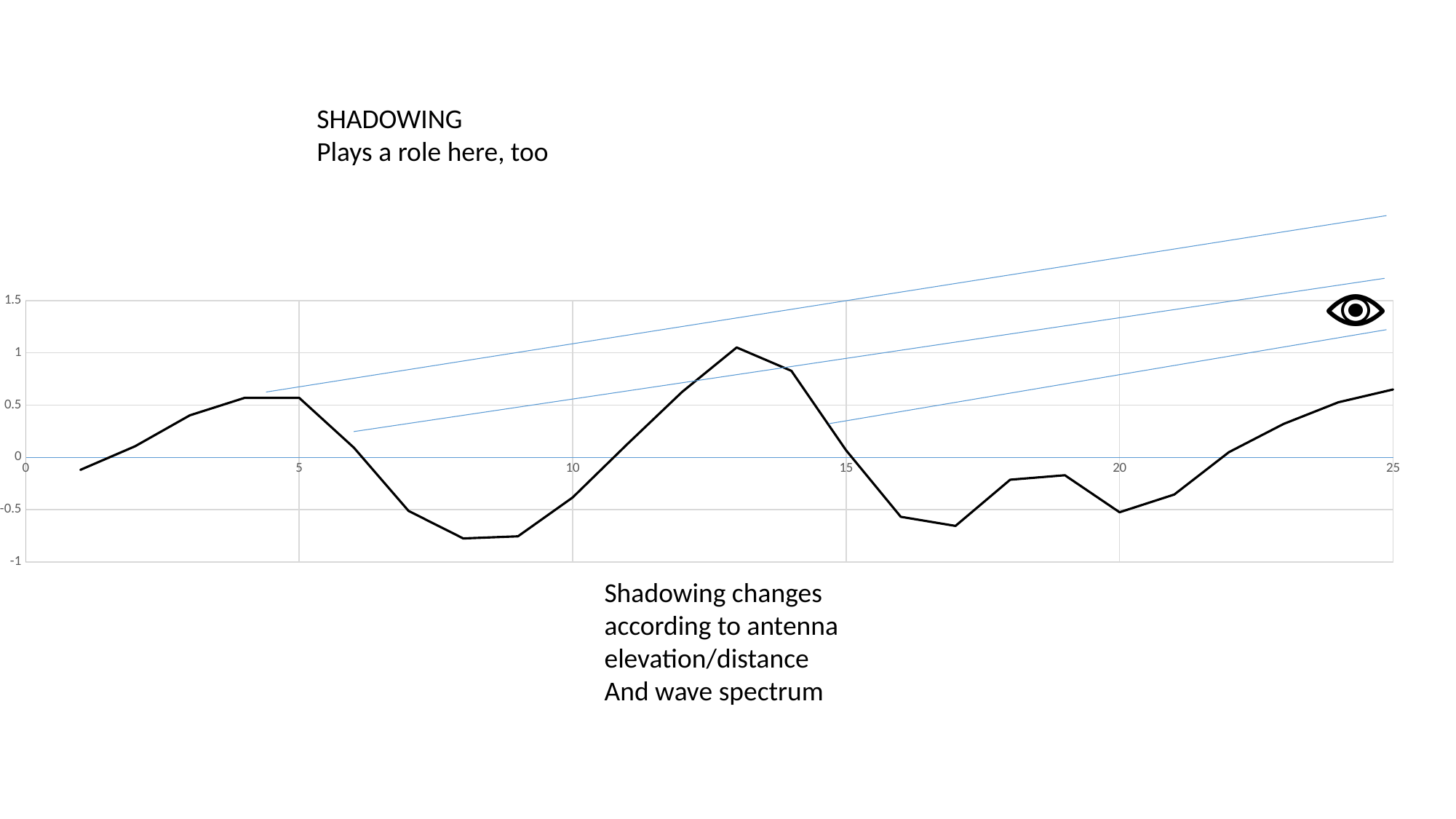
Is the value of the black line at x = 10 greater or less than 0? less Is the value of the black line at x = 12 greater or less than 0.5? greater Is the value of the black line at x = 25 greater or less than 0.5? greater What is the highest value labelled on the y axis? 1.5 What kind of chart is shown on the slide? line chart Does the black line rise or fall between x = 5 and x = 8? fall Which is higher: the peak of the black line near x = 4 or the peak near x = 13? the peak near x = 13 Around which x value does the black line reach its lowest point? 8 Around which x value does the black line reach its highest point? 13